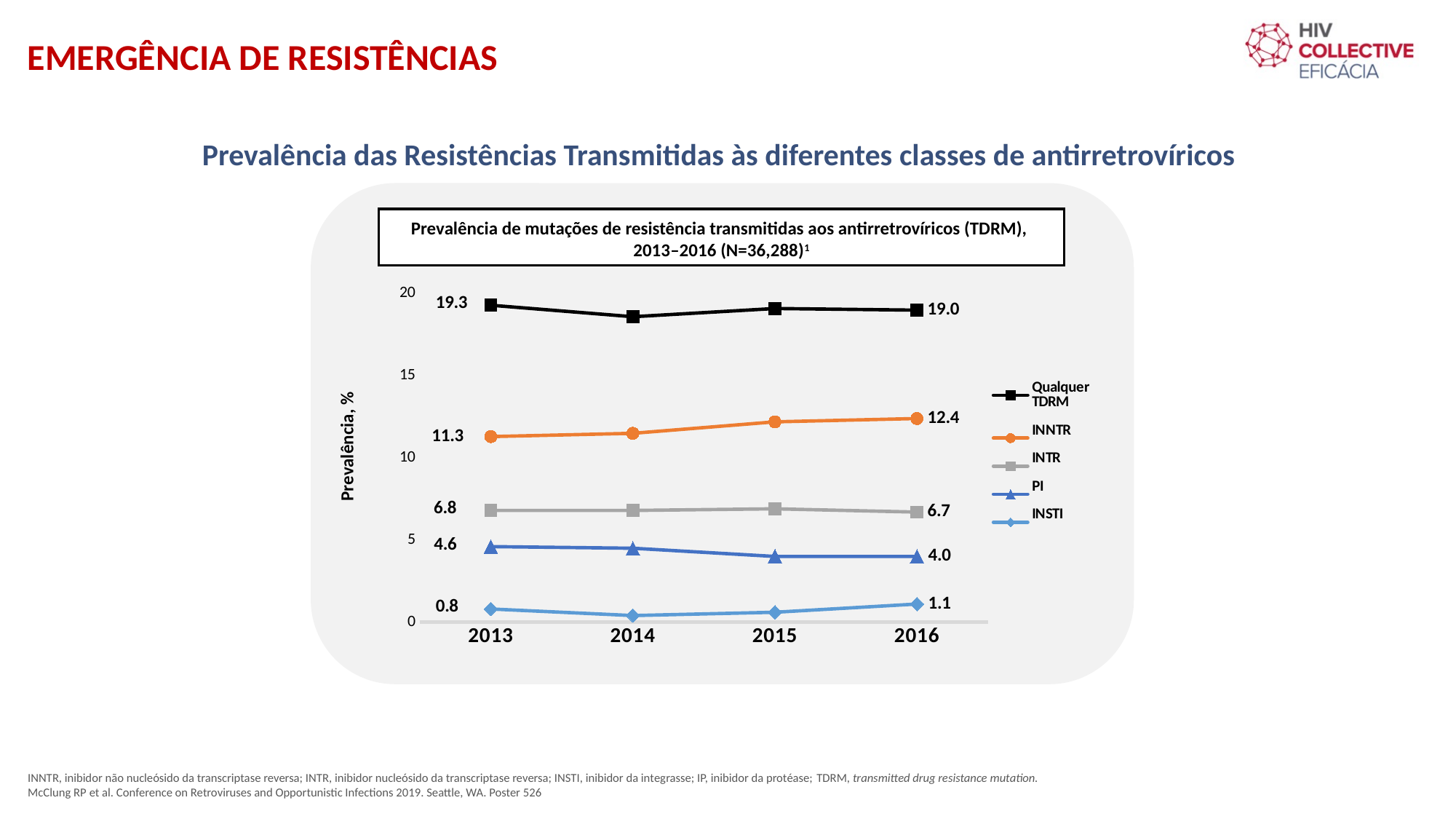
Which series has the highest value in 2016? Qualquer TDRM What is the value for Qualquer TDRM in 2013? 19.3 Which series has the lowest value in 2013? INSTI Is the value for INNTR in 2014 greater or less than 15? less Which is larger, the PI value in 2013 or the PI value in 2016? 2013 What is the value for INSTI in 2013? 0.8 Does the INNTR series rise or fall from 2013 to 2016? Rise How many series does the legend list? 5 What is the difference between the INNTR values in 2016 and 2013? 1.1 What kind of chart is shown? Line chart What is the value for INNTR in 2016? 12.4 What is the value for PI in 2016? 4.0